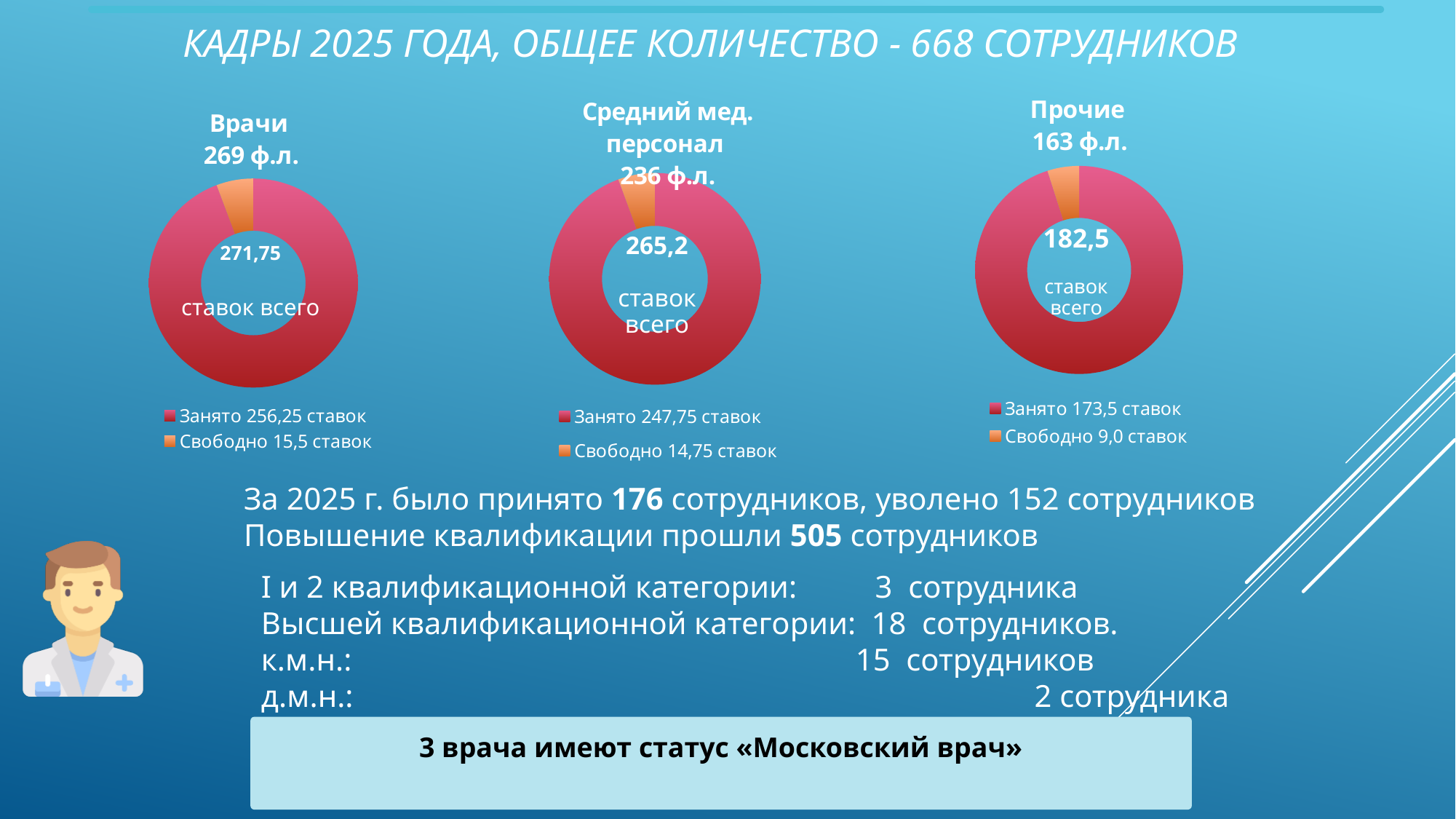
Which of the three charts has the highest Свободно value? Врачи In the 'Врачи' chart, how many ставок are listed as Занято in the legend? 256,25 ставок What kind of chart is used for the 'Врачи' data on the slide? pie chart (donut) In the 'Прочие' chart, what is the value for Свободно? 9,0 ставок In the 'Прочие' chart, what is the value for Занято? 173,5 ставок In the 'Средний мед. персонал' chart, what is the value for Свободно? 14,75 ставок In the 'Врачи' chart, what is the difference between the Занято and Свободно values? 240,75 How many slices does the 'Прочие' chart have? 2 In the 'Прочие' chart, which slice is larger, Занято or Свободно? Занято In the 'Средний мед. персонал' chart, what is the value for Занято? 247,75 ставок What total number of ставок is shown in the centre of the 'Средний мед. персонал' chart? 265,2 In the 'Врачи' chart, how many ставок are listed as Свободно? 15,5 ставок